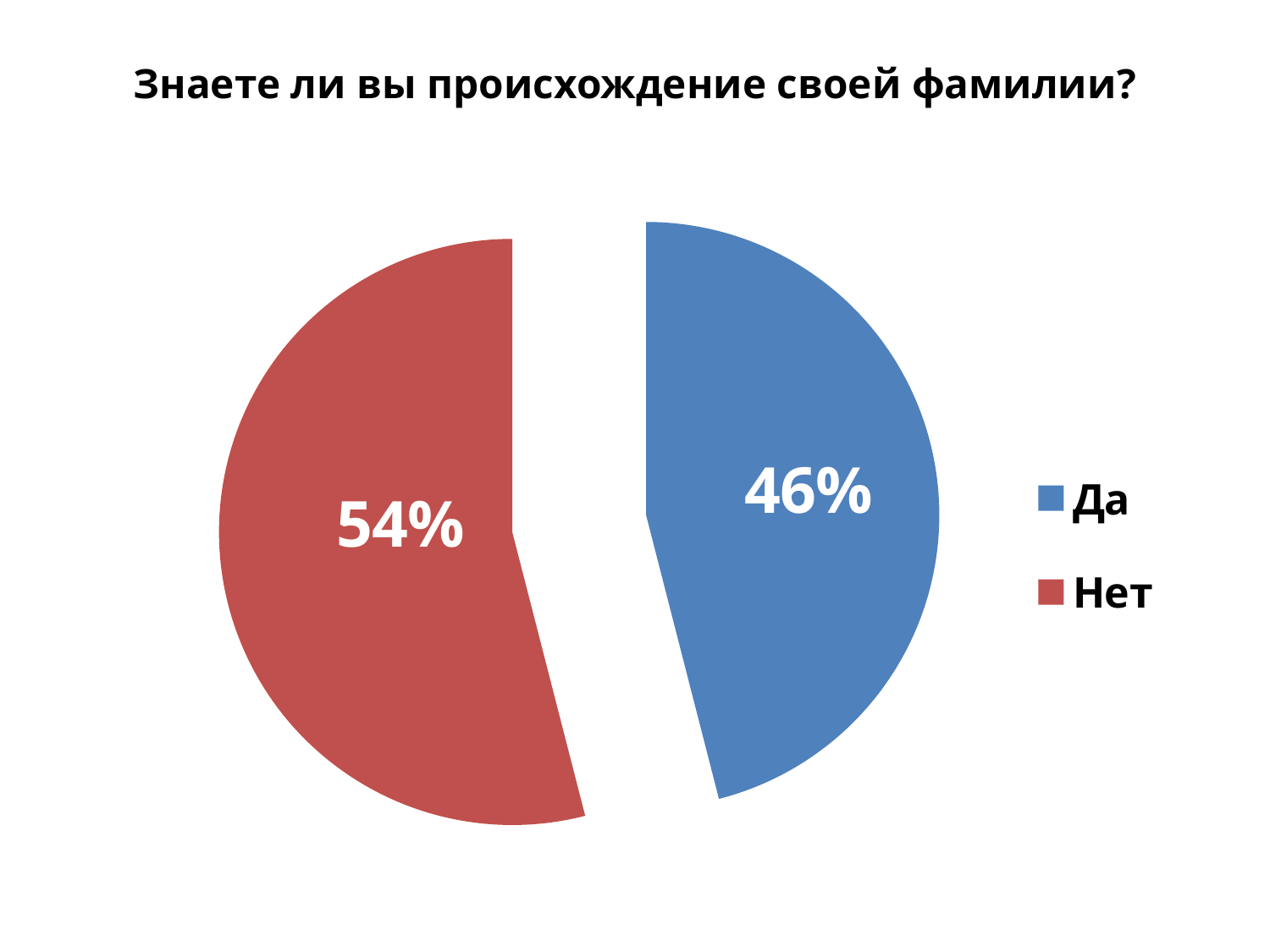
What is the title of the chart? Знаете ли вы происхождение своей фамилии? Which answer has the largest share of the pie? Нет Which slice is larger, "Да" or "Нет"? Нет What kind of chart is shown on the slide? Pie chart How many slices does the pie chart have? 2 What colour is the "Нет" slice? Red What is the difference in percentage points between the "Нет" and "Да" slices? 8 What share of the pie does the "Да" slice represent? 46% Which answer has the smallest share of the pie? Да What percentage of respondents answered "Нет"? 54% What percentage of respondents answered "Да"? 46%